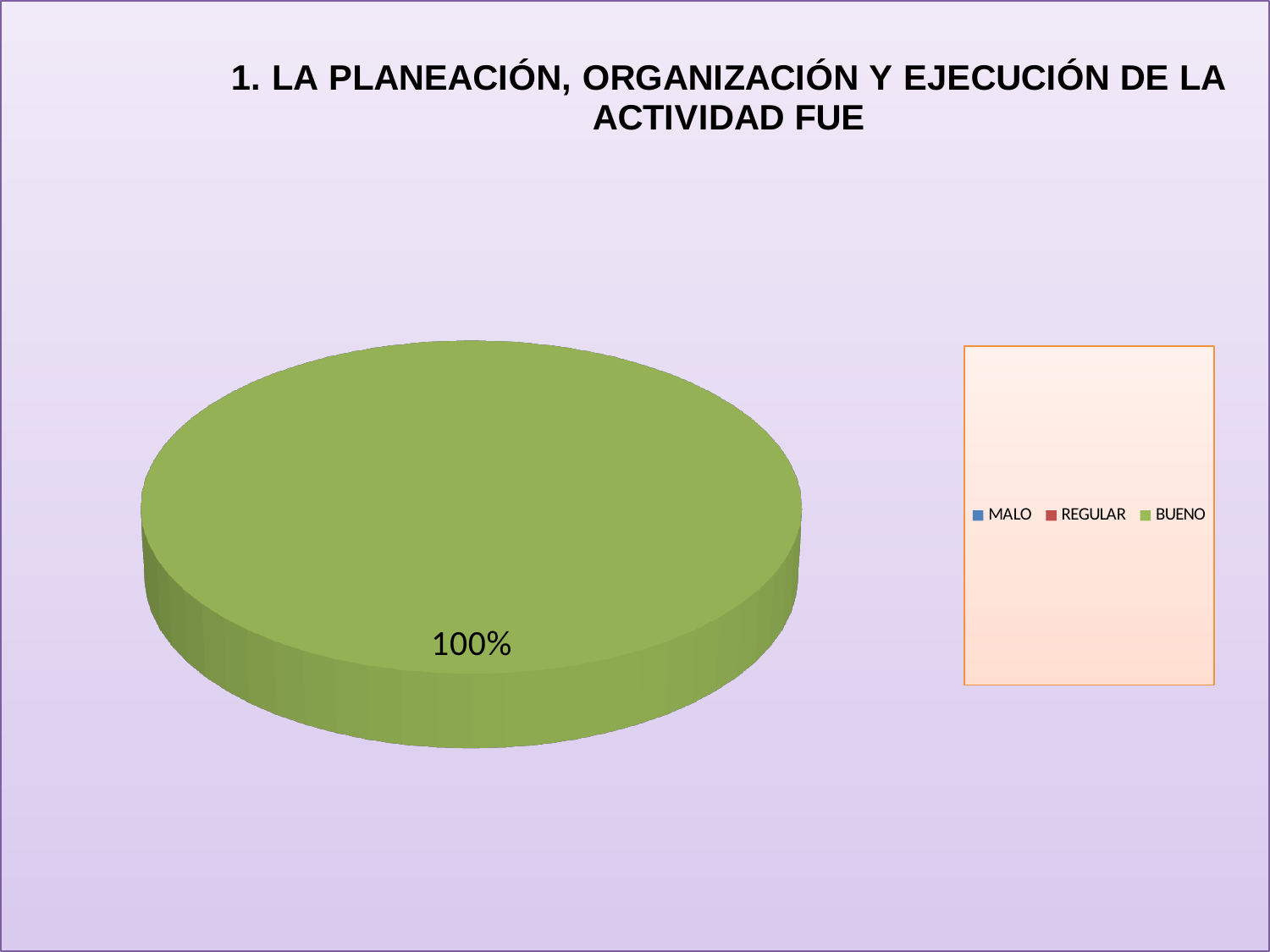
How many slices are visible in the pie? 1 Is the share for BUENO greater or less than 50%? greater What colour is the BUENO slice? green What share of the pie does BUENO take? 100% Which is larger, the share for BUENO or the share for MALO? BUENO What kind of chart is shown on the slide? pie chart Which categories are listed in the legend? MALO, REGULAR, BUENO How many categories does the legend list? 3 Which category has the largest share of the pie? BUENO What is the value printed on the pie slice? 100%